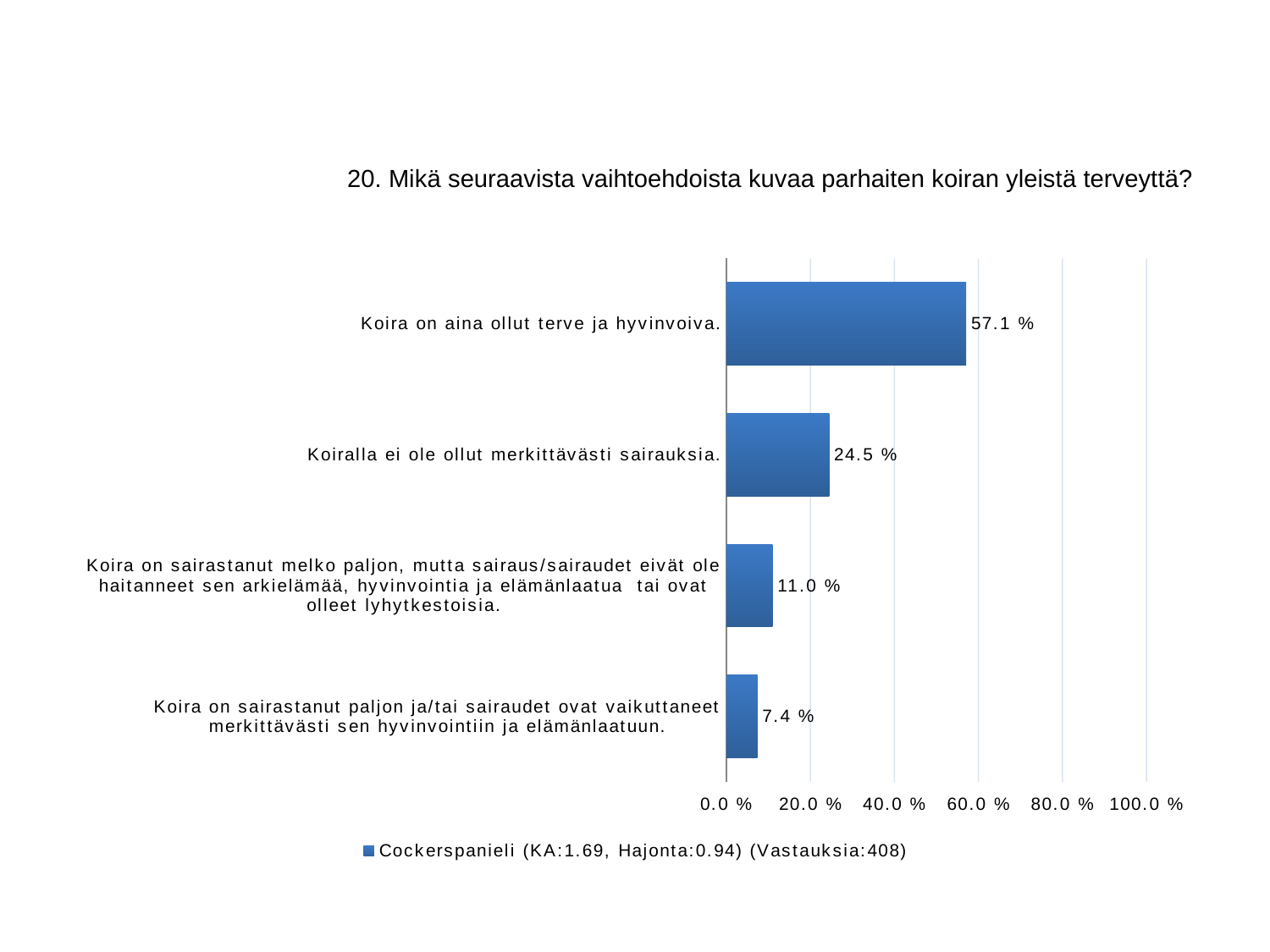
What percentage is shown for "Koira on sairastanut paljon ja/tai sairaudet ovat vaikuttaneet merkittävästi sen hyvinvointiin ja elämänlaatuun."? 7.4 % What kind of chart is shown on the slide? bar chart How many series does the legend list? 1 Which category has the lowest percentage? Koira on sairastanut paljon ja/tai sairaudet ovat vaikuttaneet merkittävästi sen hyvinvointiin ja elämänlaatuun. What percentage is shown for "Koiralla ei ole ollut merkittävästi sairauksia."? 24.5 % What is the difference in percentage points between "Koira on aina ollut terve ja hyvinvoiva." and "Koiralla ei ole ollut merkittävästi sairauksia."? 32.6 How many categories are shown in the chart? 4 Is the value for "Koira on aina ollut terve ja hyvinvoiva." greater or less than 40.0 %? greater Which category has the highest percentage? Koira on aina ollut terve ja hyvinvoiva. How many responses (Vastauksia) does the legend report? 408 Which is larger: the value for "Koiralla ei ole ollut merkittävästi sairauksia." or the value for the category starting "Koira on sairastanut melko paljon"? Koiralla ei ole ollut merkittävästi sairauksia. What percentage is shown for "Koira on aina ollut terve ja hyvinvoiva."? 57.1 %